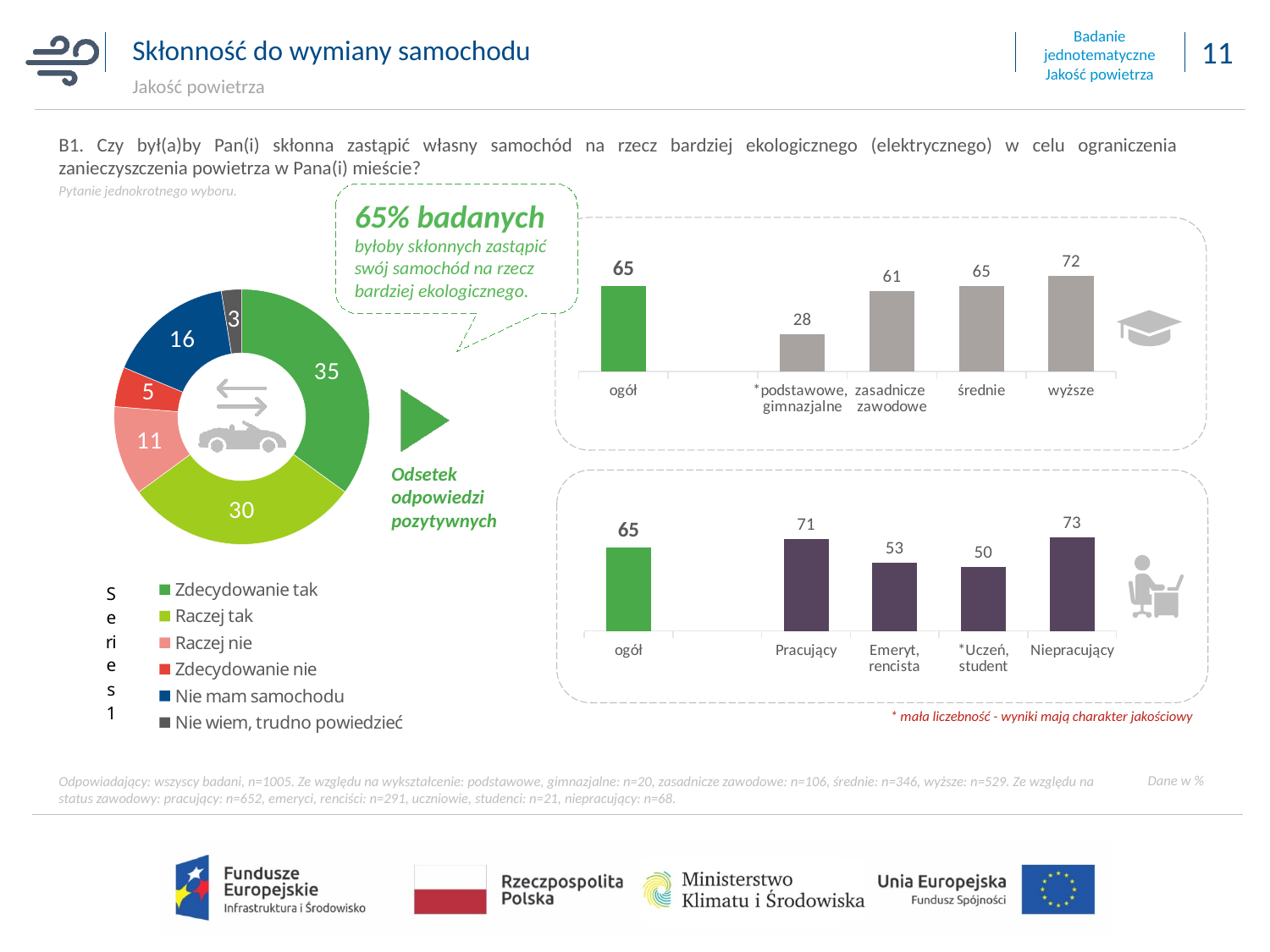
In the bottom-right bar chart (by employment status), what is the value for "Emeryt, rencista"? 53 In the top-right bar chart (by education), what is the difference between "wyższe" and "podstawowe, gimnazjalne"? 44 In the top-right bar chart (by education), which category has the lowest value? podstawowe, gimnazjalne In the bottom-right bar chart (by employment status), which is larger: "Pracujący" or "Uczeń, student"? Pracujący In the top-right bar chart (by education), how many bars are plotted? 5 In the donut chart on the left, how many categories does the legend list? 6 In the donut chart on the left, what is the value for "Zdecydowanie tak"? 35 What type of chart is the bottom-right chart (by employment status)? Bar chart In the donut chart on the left, which category has the smallest value? Nie wiem, trudno powiedzieć In the bottom-right bar chart (by employment status), which category has the highest value? Niepracujący In the donut chart on the left, what is the difference between "Raczej tak" and "Raczej nie"? 19 In the top-right bar chart (by education), what is the value for "wyższe"? 72